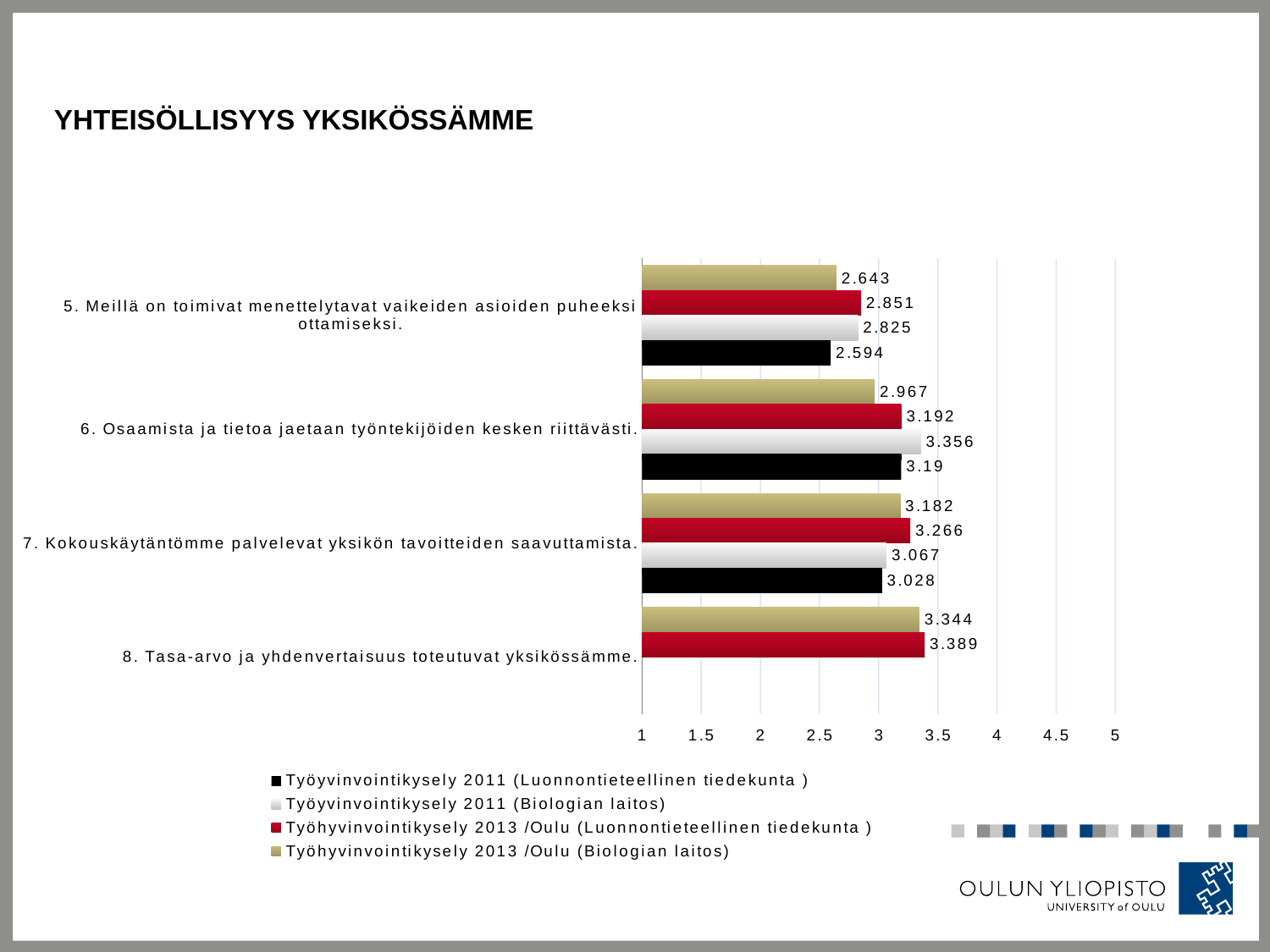
What is the value for Työyvinvointikysely 2011 (Luonnontieteellinen tiedekunta) for statement 7 (Kokouskäytäntömme palvelevat yksikön tavoitteiden saavuttamista)? 3.028 How many categories (statements) are shown on the y axis? 4 Which series has the lowest value for statement 5 (Meillä on toimivat menettelytavat vaikeiden asioiden puheeksi ottamiseksi)? Työyvinvointikysely 2011 (Luonnontieteellinen tiedekunta) What is the value for Työhyvinvointikysely 2013 /Oulu (Biologian laitos) for statement 5 (Meillä on toimivat menettelytavat vaikeiden asioiden puheeksi ottamiseksi)? 2.643 What is the value for Työyvinvointikysely 2011 (Biologian laitos) for statement 6 (Osaamista ja tietoa jaetaan työntekijöiden kesken riittävästi)? 3.356 Which series has the highest value for statement 6 (Osaamista ja tietoa jaetaan työntekijöiden kesken riittävästi)? Työyvinvointikysely 2011 (Biologian laitos) How many series does the legend list? 4 What is the difference between the Työhyvinvointikysely 2013 /Oulu (Luonnontieteellinen tiedekunta) value and the Työhyvinvointikysely 2013 /Oulu (Biologian laitos) value for statement 7? 0.084 Which statement has no bars for the 2011 survey series? 8. Tasa-arvo ja yhdenvertaisuus toteutuvat yksikössämme. For statement 6, which is larger: the Työhyvinvointikysely 2013 /Oulu (Biologian laitos) value or the Työhyvinvointikysely 2013 /Oulu (Luonnontieteellinen tiedekunta) value? Työhyvinvointikysely 2013 /Oulu (Luonnontieteellinen tiedekunta) What is the value for Työhyvinvointikysely 2013 /Oulu (Luonnontieteellinen tiedekunta) for statement 8 (Tasa-arvo ja yhdenvertaisuus toteutuvat yksikössämme)? 3.389 What type of chart is shown on the slide? bar chart